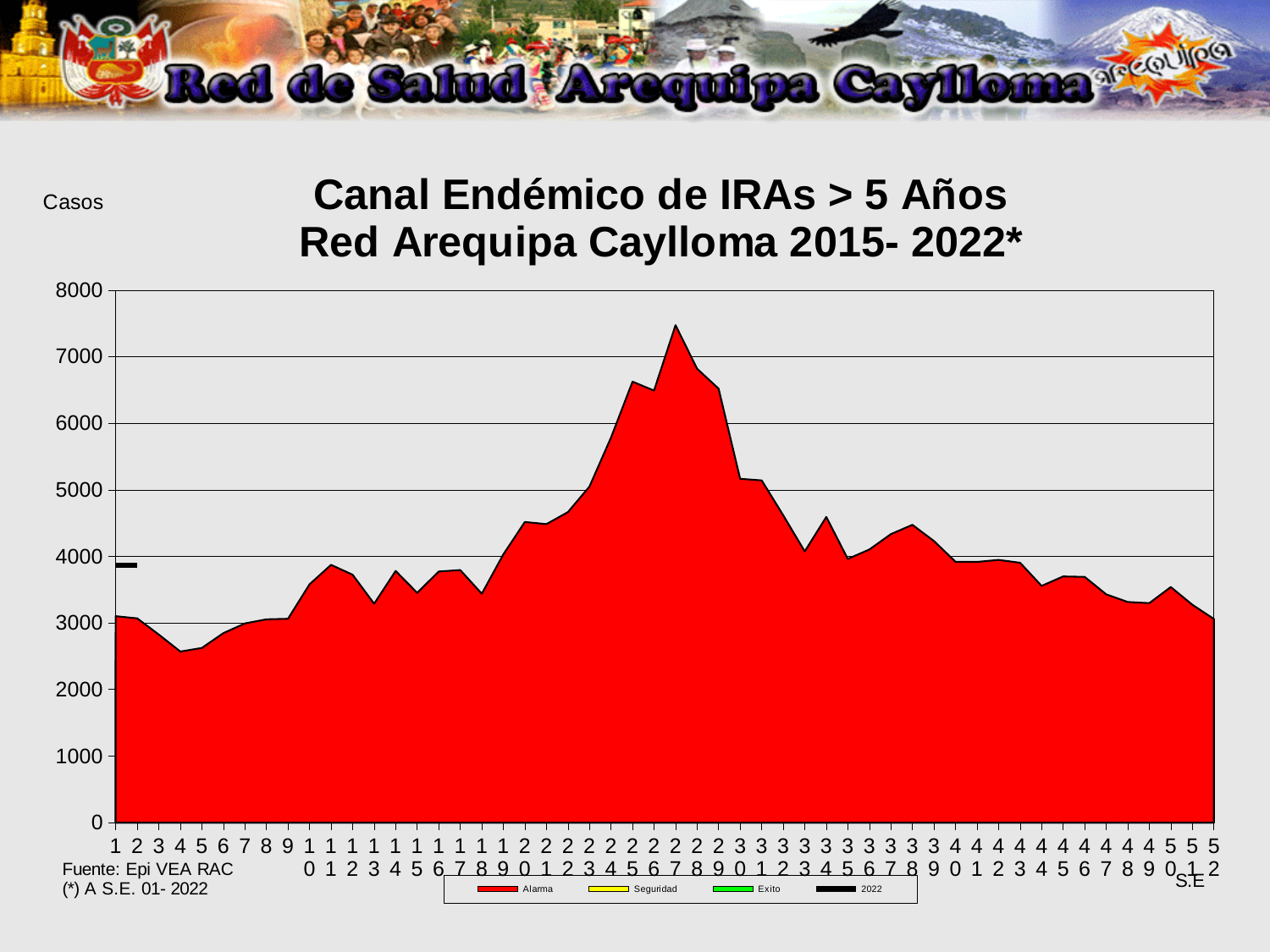
Is the value for week 27 greater or less than 7000? greater What is the label on the vertical axis of the chart? Casos Which is larger, the value for week 27 or the value for week 1? Week 27 How many series does the legend list? 4 At which week (S.E.) does the Alarma area reach its highest value? 27 Do the values rise or fall from week 20 to week 27? Rise Which series is drawn in red in the legend? Alarma Is the value for week 4 greater or less than 3000? less What kind of chart is shown on the slide? Area chart Is the value for week 25 greater or less than 6000? greater How many epidemiological weeks (S.E.) are shown along the x axis? 52